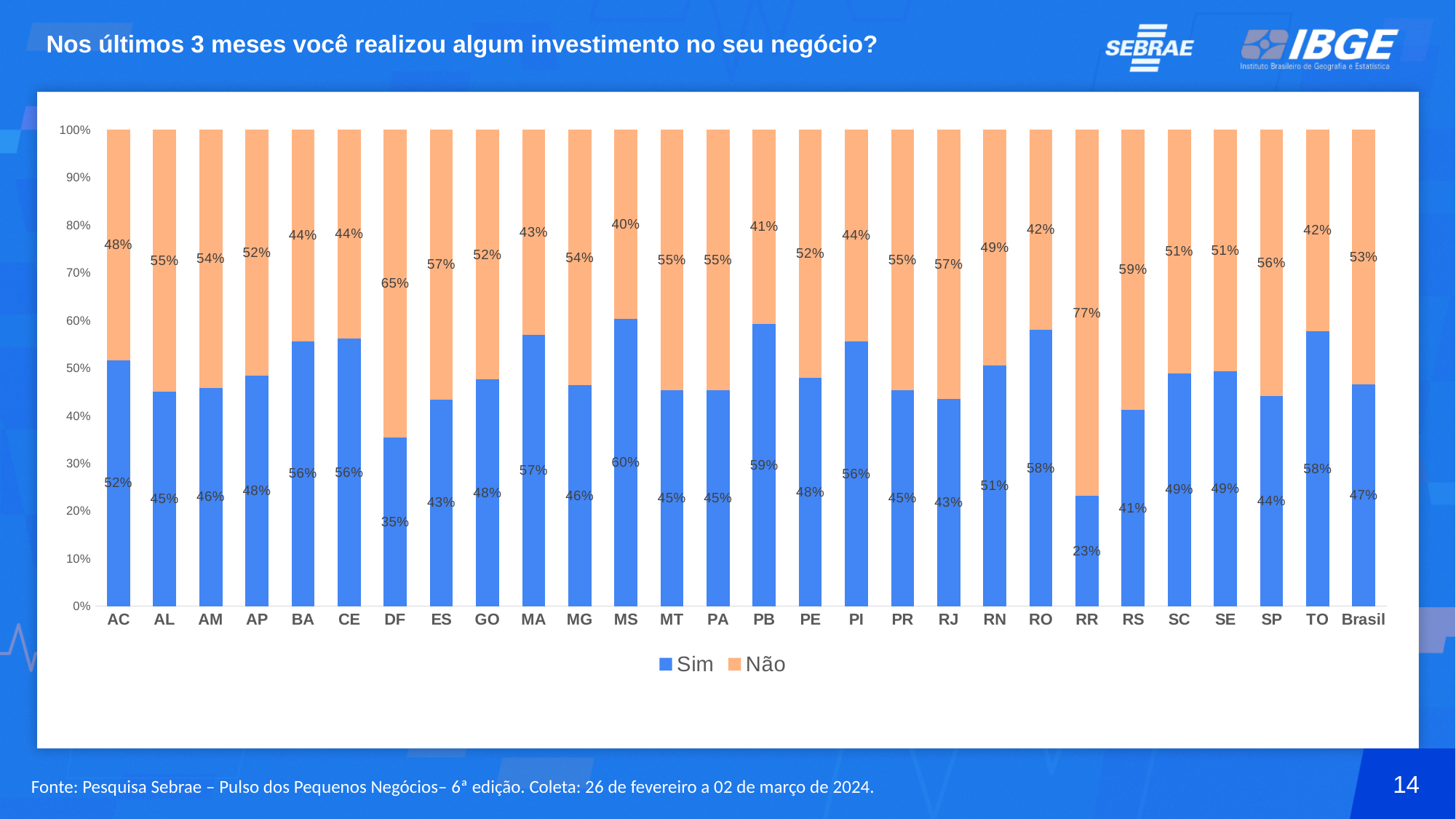
Which category has the highest 'Sim' value? MS What is the 'Não' value for DF? 65% How many categories are shown on the x axis? 28 How many series does the legend list? 2 Which has a larger 'Sim' value, RO or RS? RO What is the difference between the 'Sim' values for MS and DF? 25% What is the 'Sim' value for Brasil? 47% Which category has the lowest 'Sim' value? RR Which colour represents the 'Não' series? Orange What is the 'Sim' value for RR? 23% What kind of chart is shown on the slide? Stacked bar chart Which category has the highest 'Não' value? RR